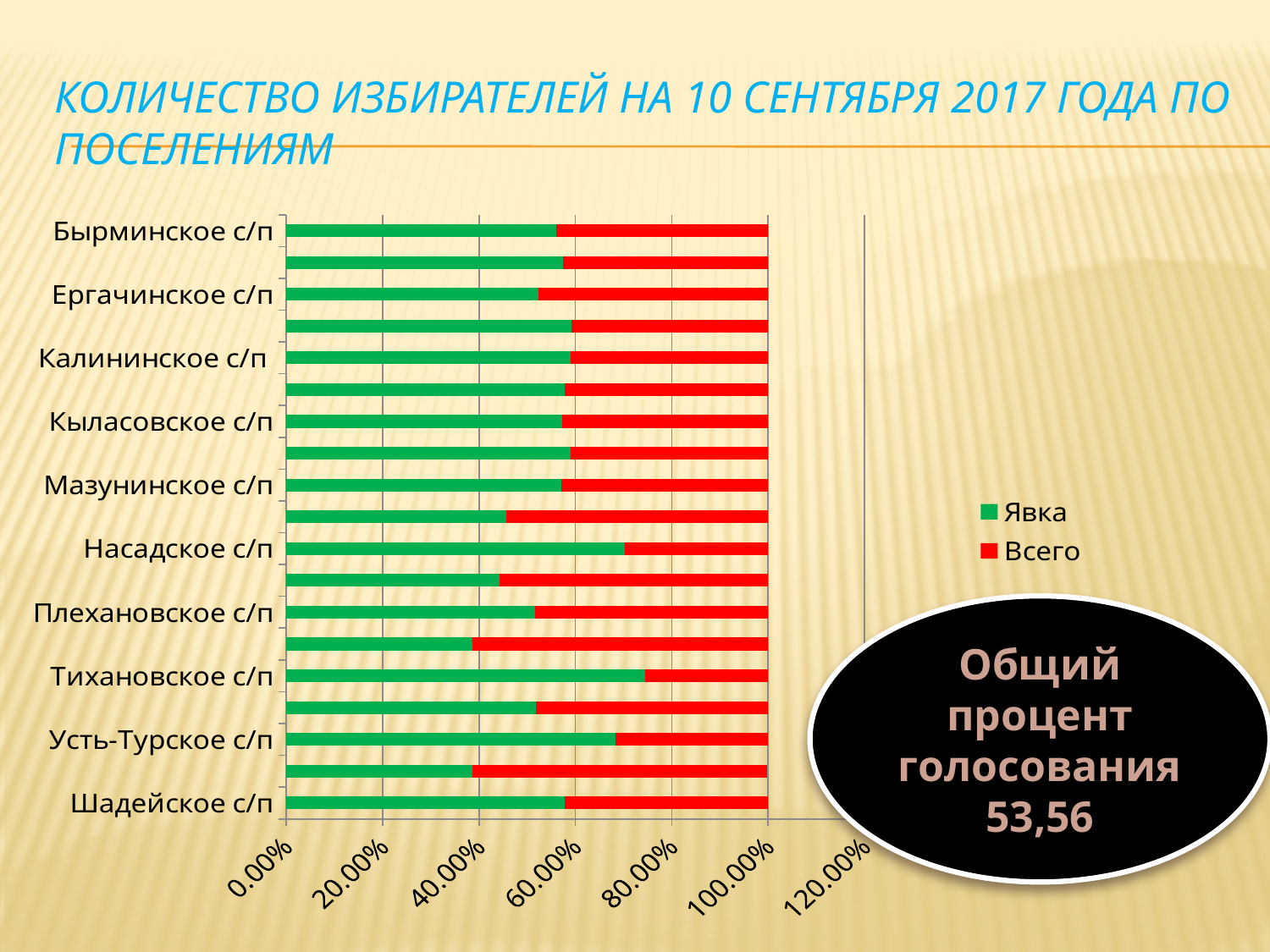
Which colour represents the series Явка? green Which has the larger Явка value, Насадское с/п or Плехановское с/п? Насадское с/п What are the two series named in the legend? Явка and Всего Among the labelled settlements, which has the highest Явка value? Тихановское с/п Is the Явка value for Тихановское с/п greater or less than 60.00%? greater Is the Явка value for Насадское с/п greater or less than 60.00%? greater Is the Явка value for Ергачинское с/п greater or less than 60.00%? less How many bars are plotted in the chart? 19 Which has the larger Явка value, Тихановское с/п or Ергачинское с/п? Тихановское с/п How many series does the legend list? 2 What kind of chart is shown on the slide? bar chart